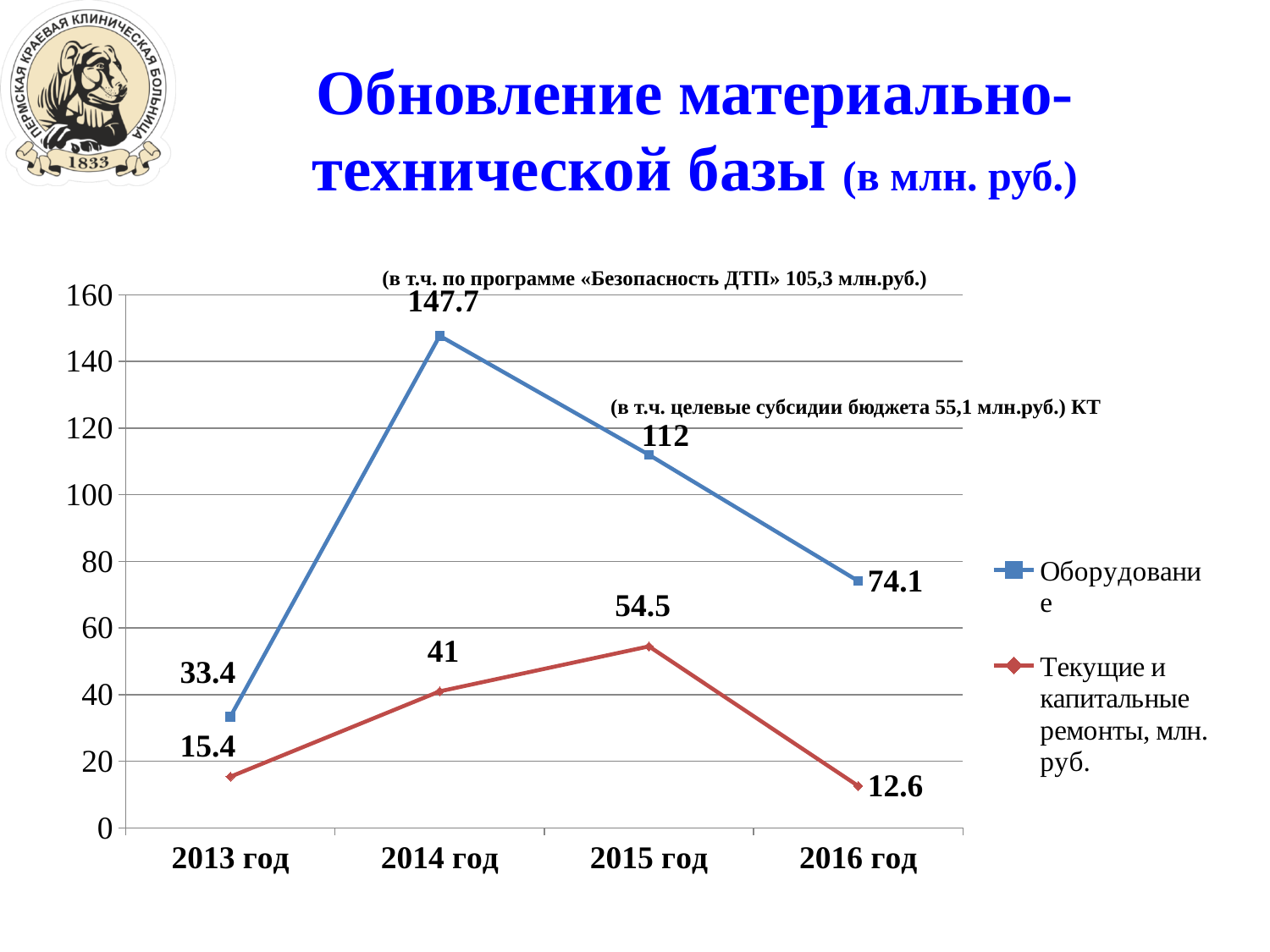
What is the value for Оборудование in 2013 год? 33.4 Does the Оборудование series rise or fall from 2014 год to 2016 год? fall In which year is the Оборудование series highest? 2014 год Which is larger in 2014 год: Оборудование or Текущие и капитальные ремонты? Оборудование What is the difference between Оборудование and Текущие и капитальные ремонты in 2015 год? 57.5 Is the value for Оборудование in 2016 год greater or less than 80? less How many series does the legend list? 2 How many years are shown on the x axis? 4 What kind of chart is shown on the slide? line chart What is the value for Оборудование in 2014 год? 147.7 What is the value for Текущие и капитальные ремонты in 2016 год? 12.6 In which year is the Текущие и капитальные ремонты series lowest? 2016 год